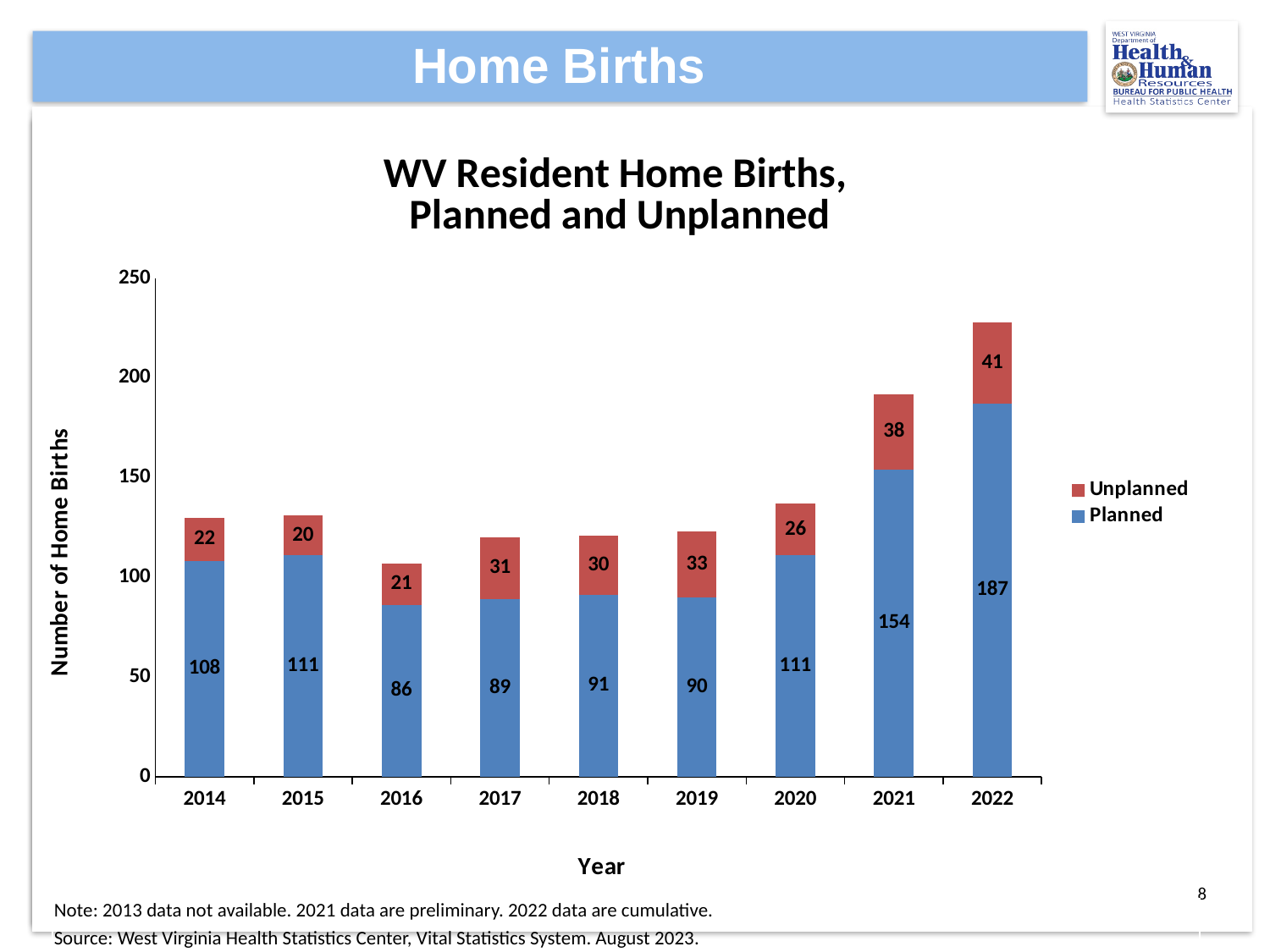
Which year had more unplanned home births, 2018 or 2019? 2019 Which year has the highest number of planned home births? 2022 Which year has the lowest number of planned home births? 2016 What is the number of unplanned home births in 2017? 31 Do planned home births rise or fall from 2020 to 2022? Rise What kind of chart is shown on the slide? Stacked bar chart How many years are shown on the x axis of the chart? 9 How many more planned home births were there in 2022 than in 2021? 33 What is the total number of home births (planned plus unplanned) in 2021? 192 How many series does the legend list? 2 Which year has the lowest number of unplanned home births? 2015 What is the number of planned home births in 2022? 187